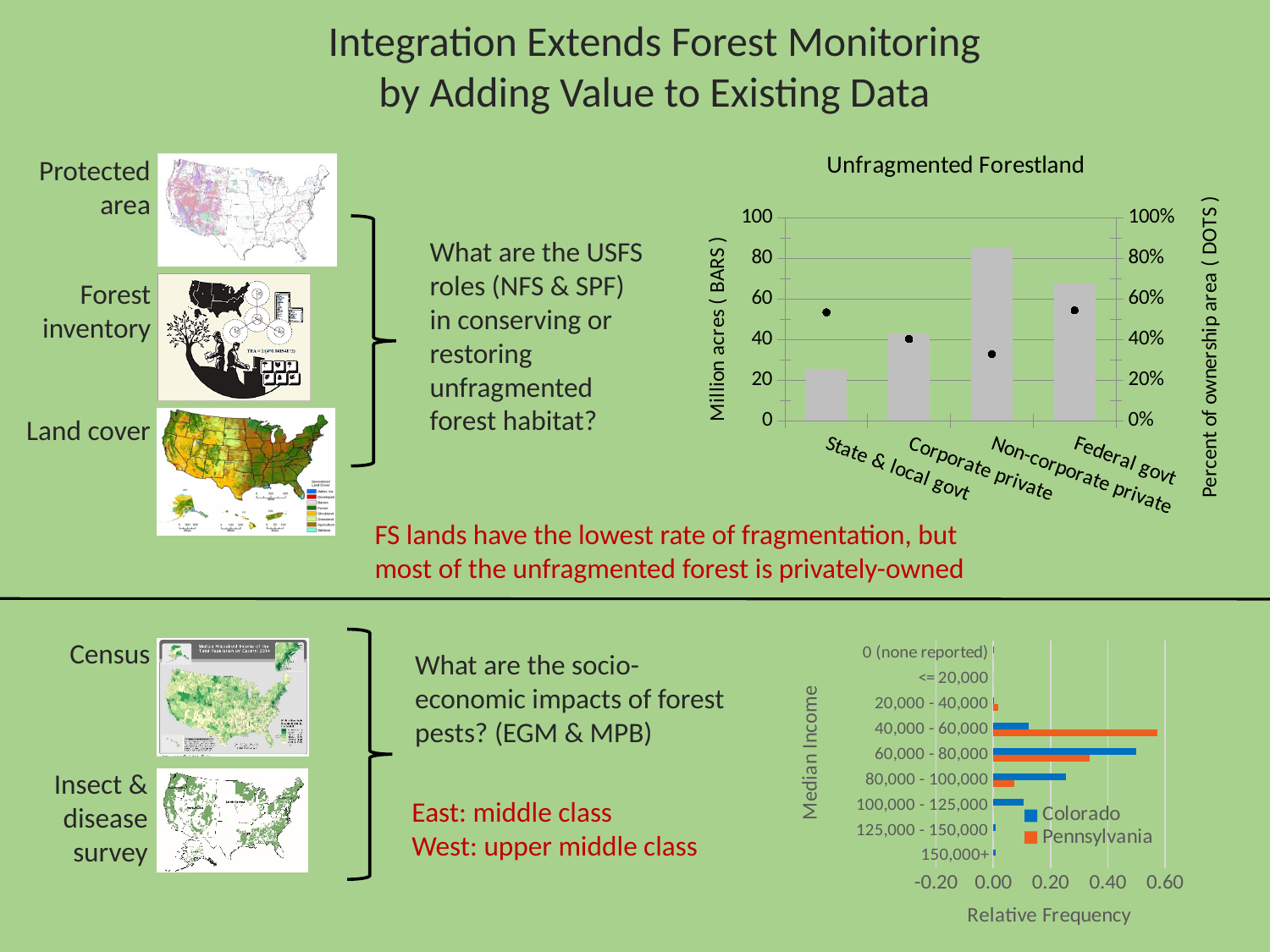
In the bottom-right Median Income chart, which income bin has the longest Pennsylvania bar? 40,000 - 60,000 In the bottom-right Median Income chart, which income bin has the longest Colorado bar? 60,000 - 80,000 In the bottom-right Median Income chart, for the 40,000 - 60,000 bin, which state has the larger relative frequency? Pennsylvania In the Unfragmented Forestland chart, which ownership category has the lowest dot (percent of ownership area)? Non-corporate private In the Unfragmented Forestland chart, what does the right-hand axis measure? Percent of ownership area (DOTS) In the Unfragmented Forestland chart, which ownership category has the tallest bar (million acres)? Non-corporate private In the Unfragmented Forestland chart, is the bar for Non-corporate private greater or less than 80 million acres? greater In the Unfragmented Forestland chart, is the bar for State & local govt greater or less than 40 million acres? less In the bottom-right Median Income chart, how many series does the legend list? 2 How many ownership categories are shown on the x axis of the Unfragmented Forestland chart? 4 In the Unfragmented Forestland chart, which ownership category has the shortest bar (million acres)? State & local govt In the Unfragmented Forestland chart, is the bar for Federal govt greater or less than 60 million acres? greater